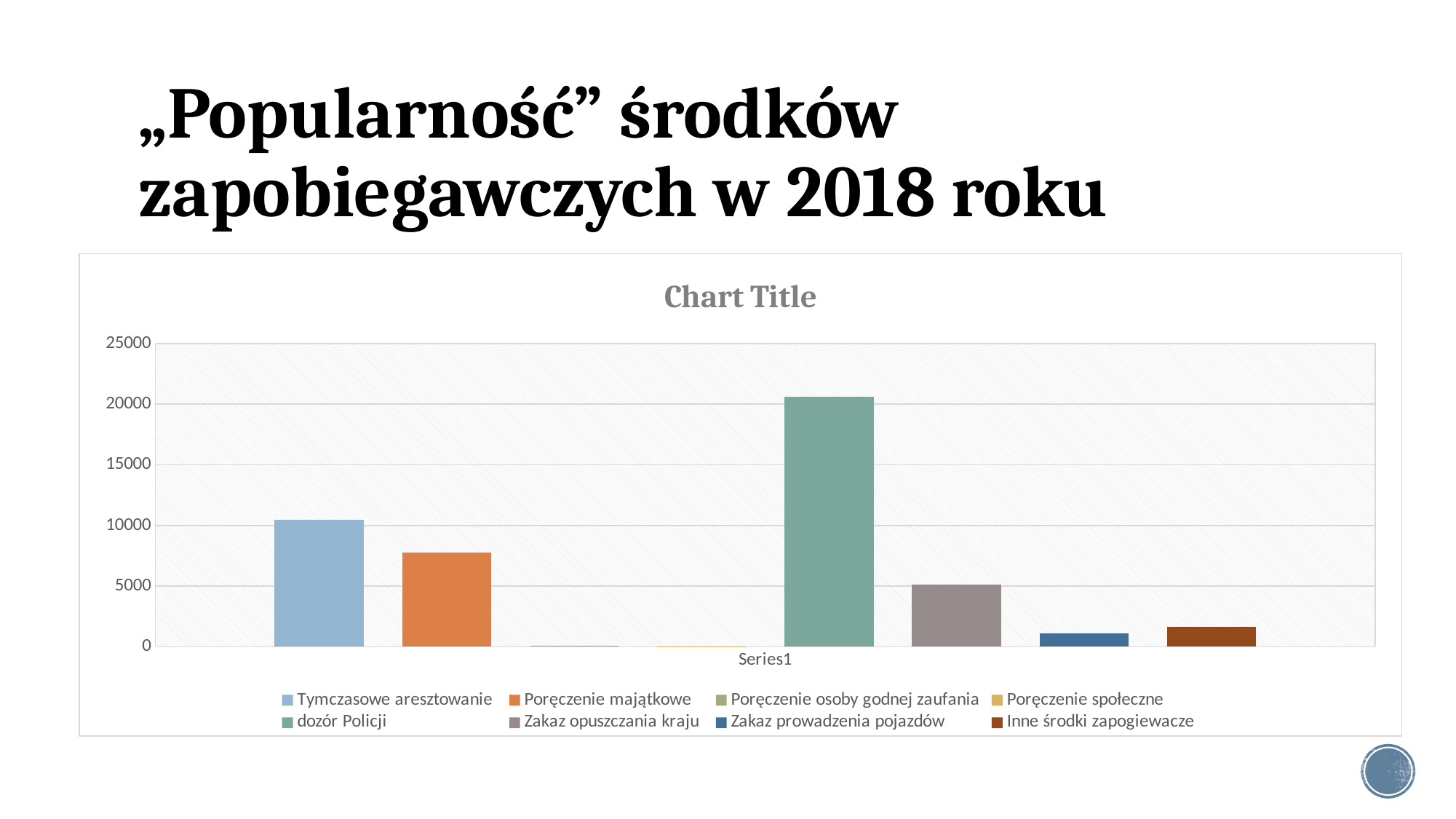
Which is larger, the value for Tymczasowe aresztowanie or the value for Poręczenie majątkowe? Tymczasowe aresztowanie What is the title shown above the chart? Chart Title Which category has the highest value in the chart? dozór Policji How many entries does the chart legend list? 8 What kind of chart is shown on the slide? bar chart Is the value for Inne środki zapogiewacze greater or less than 5000? less What is the label shown on the x axis below the bars? Series1 Is the value for Tymczasowe aresztowanie greater or less than 10000? greater Which is larger, the value for Zakaz opuszczania kraju or the value for Zakaz prowadzenia pojazdów? Zakaz opuszczania kraju Is the value for dozór Policji greater or less than 20000? greater